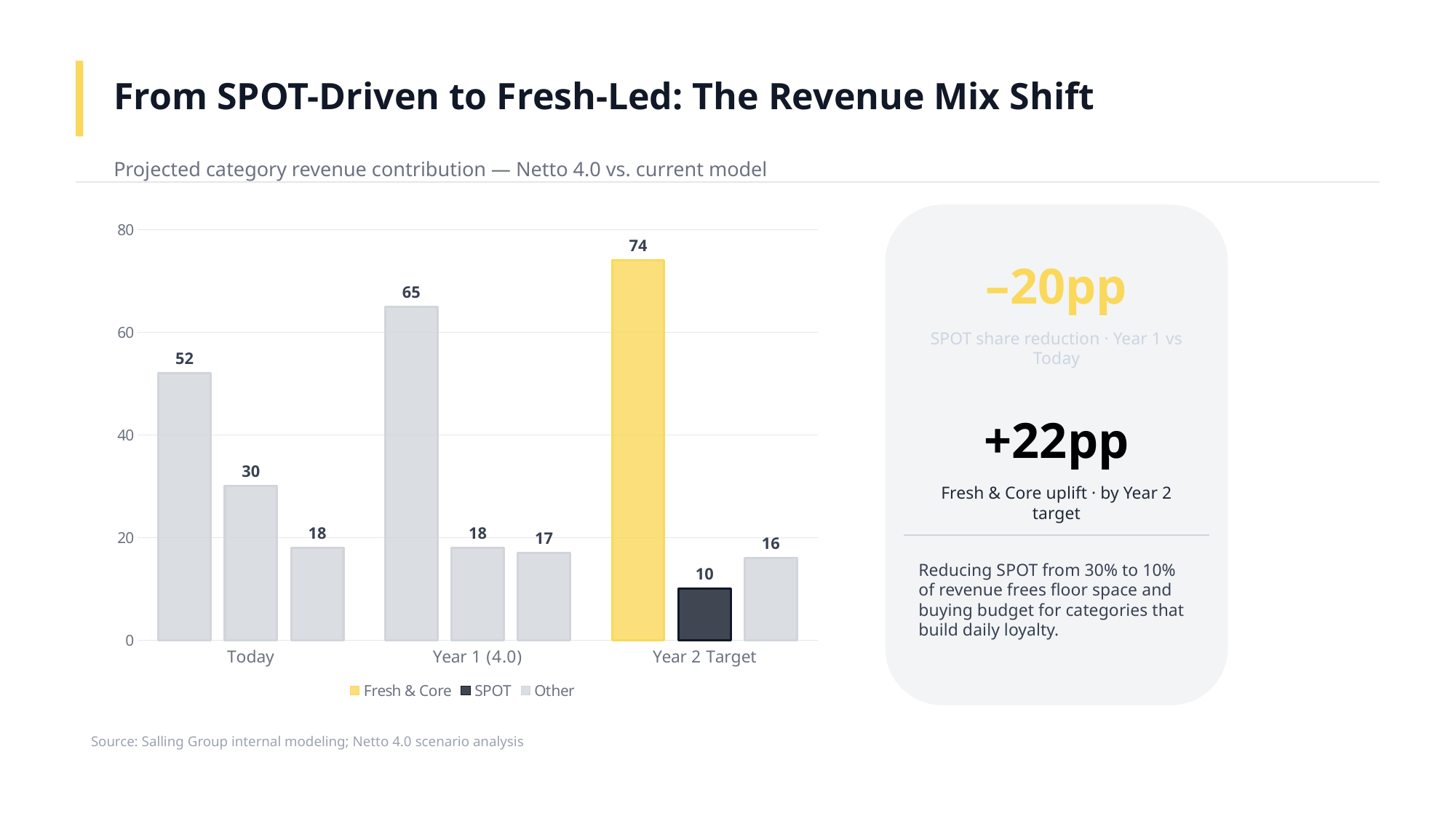
What is the difference between the Fresh & Core value in Year 2 Target (74) and the tallest bar in Today (52)? 22 What type of chart is shown on the slide? bar chart Which category has the highest single bar value? Year 2 Target Which is larger: the SPOT value in Year 2 Target or the Other value in Year 2 Target? Other How many categories are shown on the x axis? 3 What is the value of the tallest bar in the Year 1 (4.0) category? 65 Which series is shown in yellow in the legend? Fresh & Core What is the value for SPOT in the Year 2 Target category? 10 What is the value for Other in the Year 2 Target category? 16 How many series does the legend list? 3 What is the value of the tallest bar in the Today category? 52 What is the value for Fresh & Core in the Year 2 Target category? 74